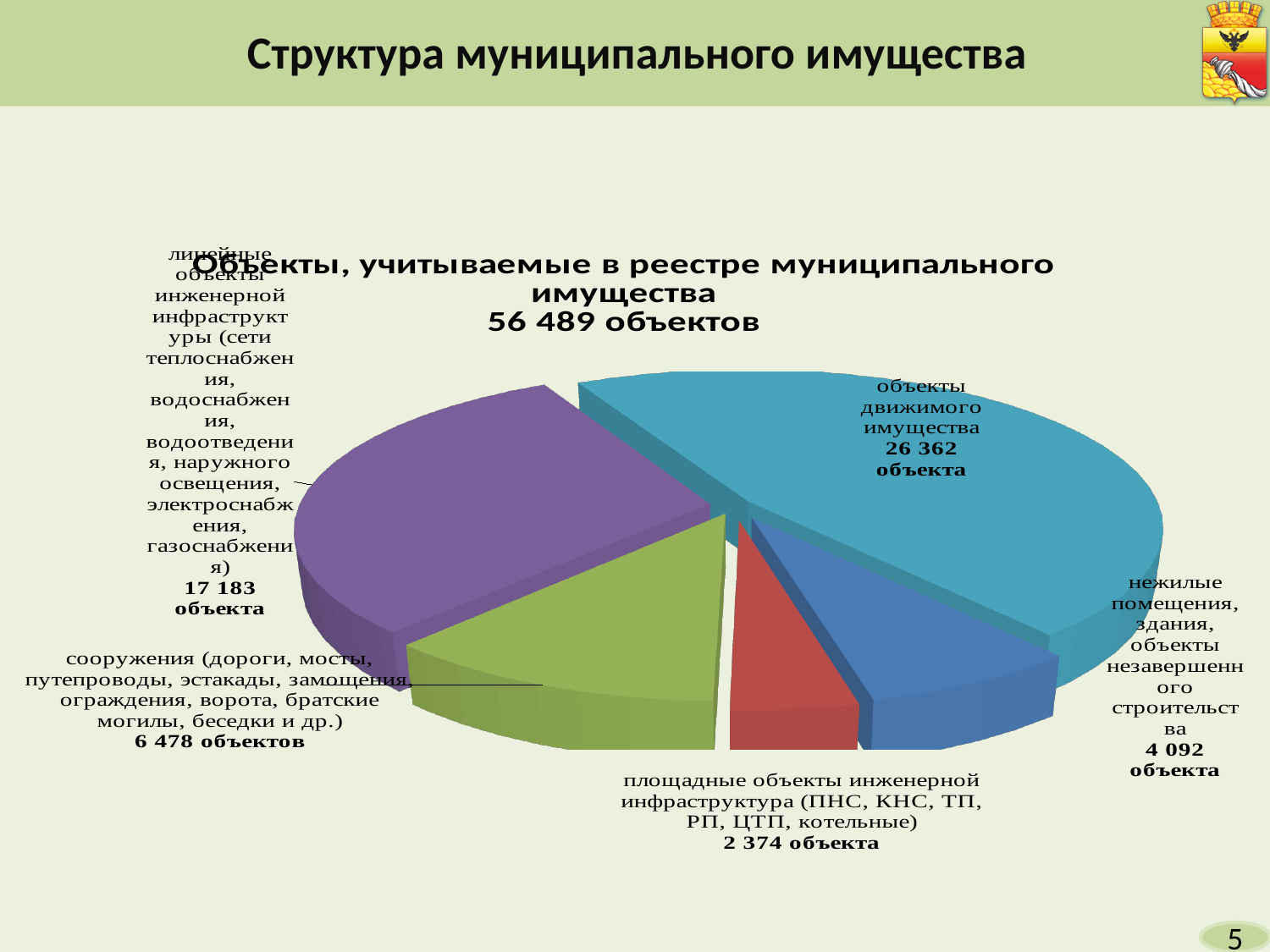
What is the difference between the number of 'объекты движимого имущества' and 'линейные объекты инженерной инфраструктуры'? 9 179 What kind of chart is shown on the slide? Pie chart How many objects are in the category 'объекты движимого имущества'? 26 362 объекта How many objects are in the category 'сооружения (дороги, мосты, путепроводы, эстакады, замощения, ограждения, ворота, братские могилы, беседки и др.)'? 6 478 объектов Which has more objects: 'сооружения' or 'нежилые помещения, здания, объекты незавершенного строительства'? сооружения How many objects are in the category 'площадные объекты инженерной инфраструктура (ПНС, КНС, ТП, РП, ЦТП, котельные)'? 2 374 объекта How many objects are in the category 'линейные объекты инженерной инфраструктуры'? 17 183 объекта How many objects are in the category 'нежилые помещения, здания, объекты незавершенного строительства'? 4 092 объекта What is the total number of objects stated in the chart title? 56 489 объектов Which category has the largest number of objects? объекты движимого имущества Which category has the smallest number of objects? площадные объекты инженерной инфраструктура (ПНС, КНС, ТП, РП, ЦТП, котельные) How many slices does the pie chart have? 5